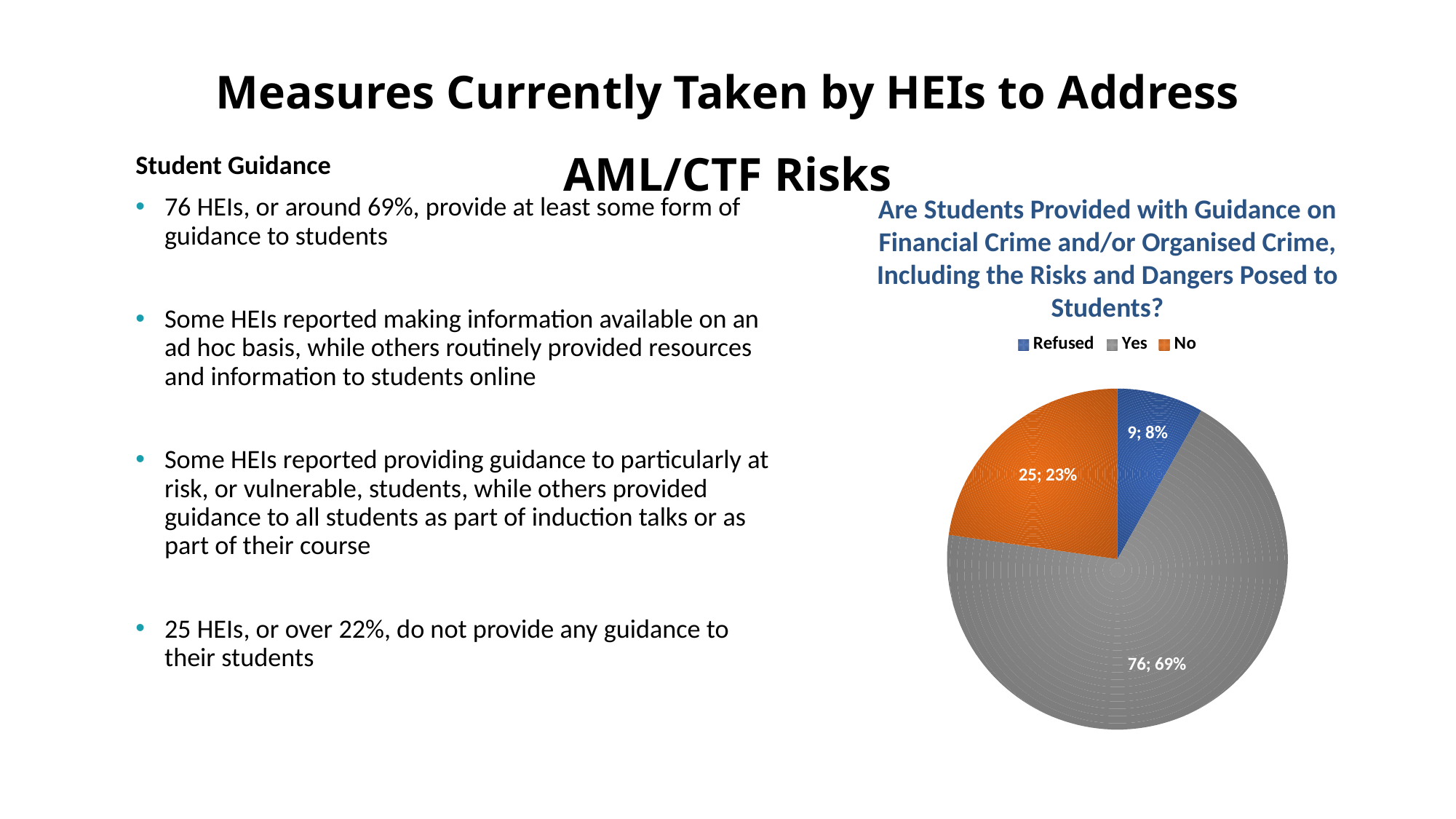
Which slice is larger, No or Refused? No Which category has the smallest slice in the pie chart? Refused How many HEIs are in the Refused category of the pie chart? 9 How many HEIs answered Yes in the pie chart? 76 Which category has the largest slice in the pie chart? Yes What is the total number of HEIs across all slices of the pie chart? 110 How many categories does the pie chart have? 3 What kind of chart is shown on the slide? pie chart What colour is the Yes slice in the pie chart? grey What percentage share does the Yes slice have in the pie chart? 69% What is the difference in count between the Yes and No slices? 51 What percentage share does the No slice have in the pie chart? 23%